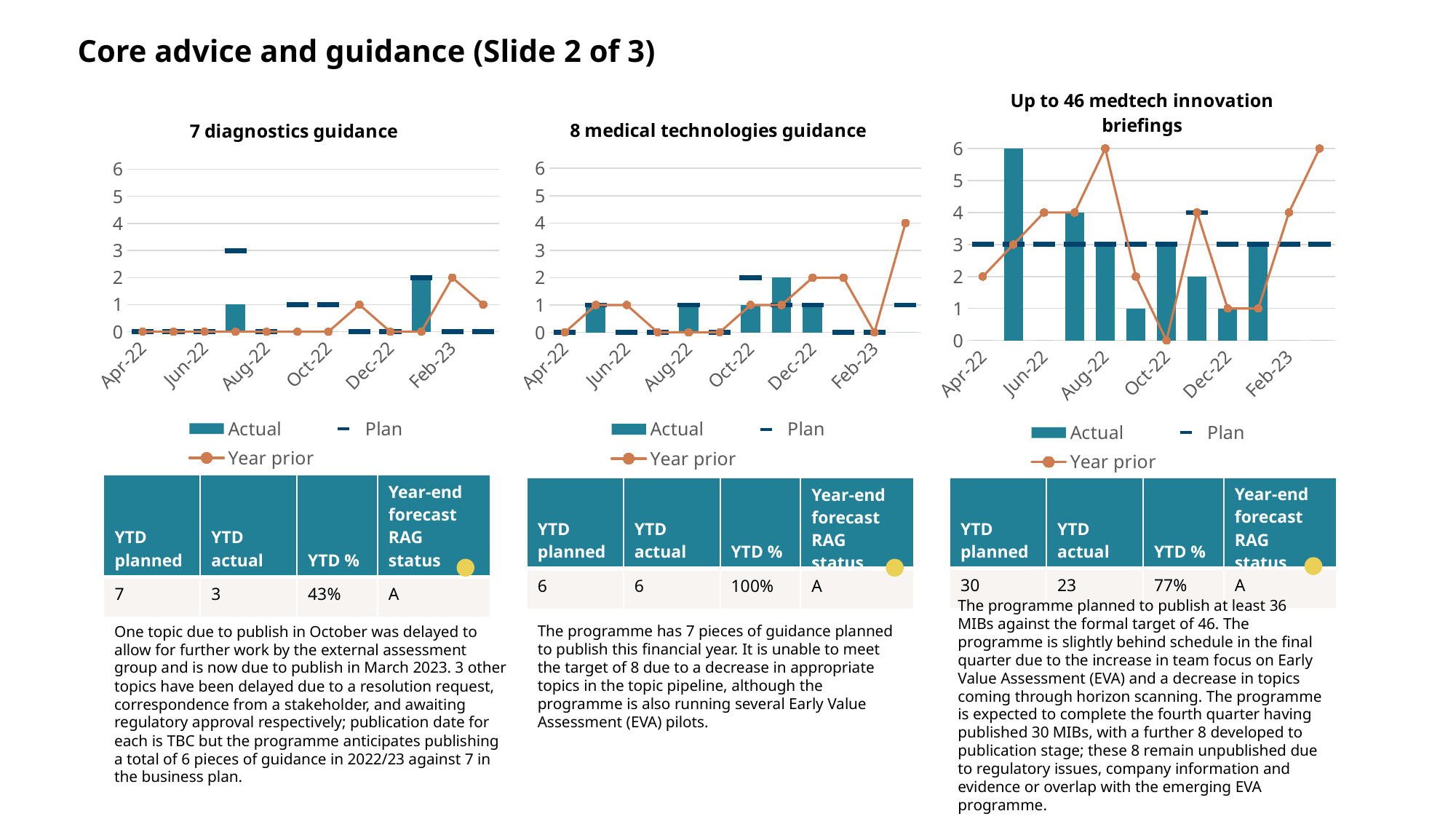
In the 'Up to 46 medtech innovation briefings' chart, what is the Year prior value for Oct-22? 0 In the '7 diagnostics guidance' chart, what is the Actual value for Oct-22? 0 In the 'Up to 46 medtech innovation briefings' chart, what is the difference between the Year prior values for Jun-22 and Apr-22? 2 In the 'Up to 46 medtech innovation briefings' chart, what is the Year prior value for Aug-22? 6 In the 'Up to 46 medtech innovation briefings' chart, what is the Actual value for Oct-22? 3 How many series does the legend of the '7 diagnostics guidance' chart list? 3 In the '7 diagnostics guidance' chart, what is the Plan value for Oct-22? 1 In the '8 medical technologies guidance' chart, what is the Actual value for Dec-22? 1 What is the title of the chart on the right of the slide? Up to 46 medtech innovation briefings In the '7 diagnostics guidance' chart, what is the Year prior value for Feb-23? 2 In the 'Up to 46 medtech innovation briefings' chart, which is larger: the Year prior value for Aug-22 or for Feb-23? Aug-22 In the '8 medical technologies guidance' chart, what is the Actual value for Aug-22? 1